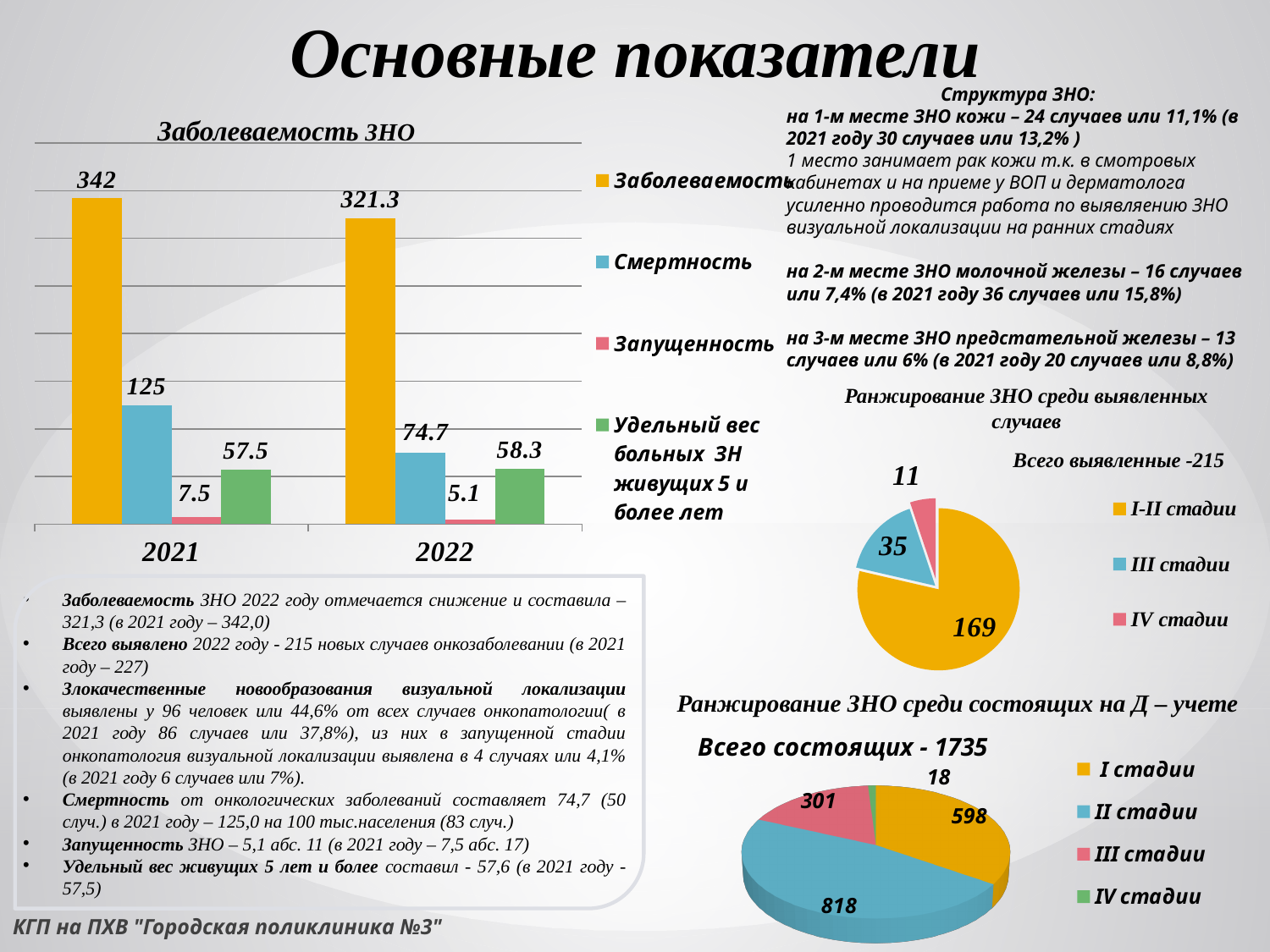
In the pie chart 'Ранжирование ЗНО среди состоящих на Д – учете', what is the value for II стадии? 818 In the bar chart 'Заболеваемость ЗНО', what is the value of Смертность for 2022? 74.7 In the pie chart 'Ранжирование ЗНО среди выявленных случаев', what is the value for III стадии? 35 In the bar chart 'Заболеваемость ЗНО', which is larger: Удельный вес больных ЗН живущих 5 и более лет in 2021 or in 2022? 2022 In the bar chart 'Заболеваемость ЗНО', by how much did Заболеваемость change from 2021 to 2022? 20.7 In the pie chart 'Ранжирование ЗНО среди состоящих на Д – учете', what is the difference between I стадии and III стадии? 297 What type of chart is 'Заболеваемость ЗНО'? bar chart In the bar chart 'Заболеваемость ЗНО', what is the value of Заболеваемость for 2021? 342 In the bar chart 'Заболеваемость ЗНО', what is the value of Запущенность for 2021? 7.5 How many series does the legend of the bar chart 'Заболеваемость ЗНО' list? 4 In the bar chart 'Заболеваемость ЗНО', does Смертность rise or fall from 2021 to 2022? fall In the pie chart 'Ранжирование ЗНО среди выявленных случаев', which stage has the smallest slice? IV стадии